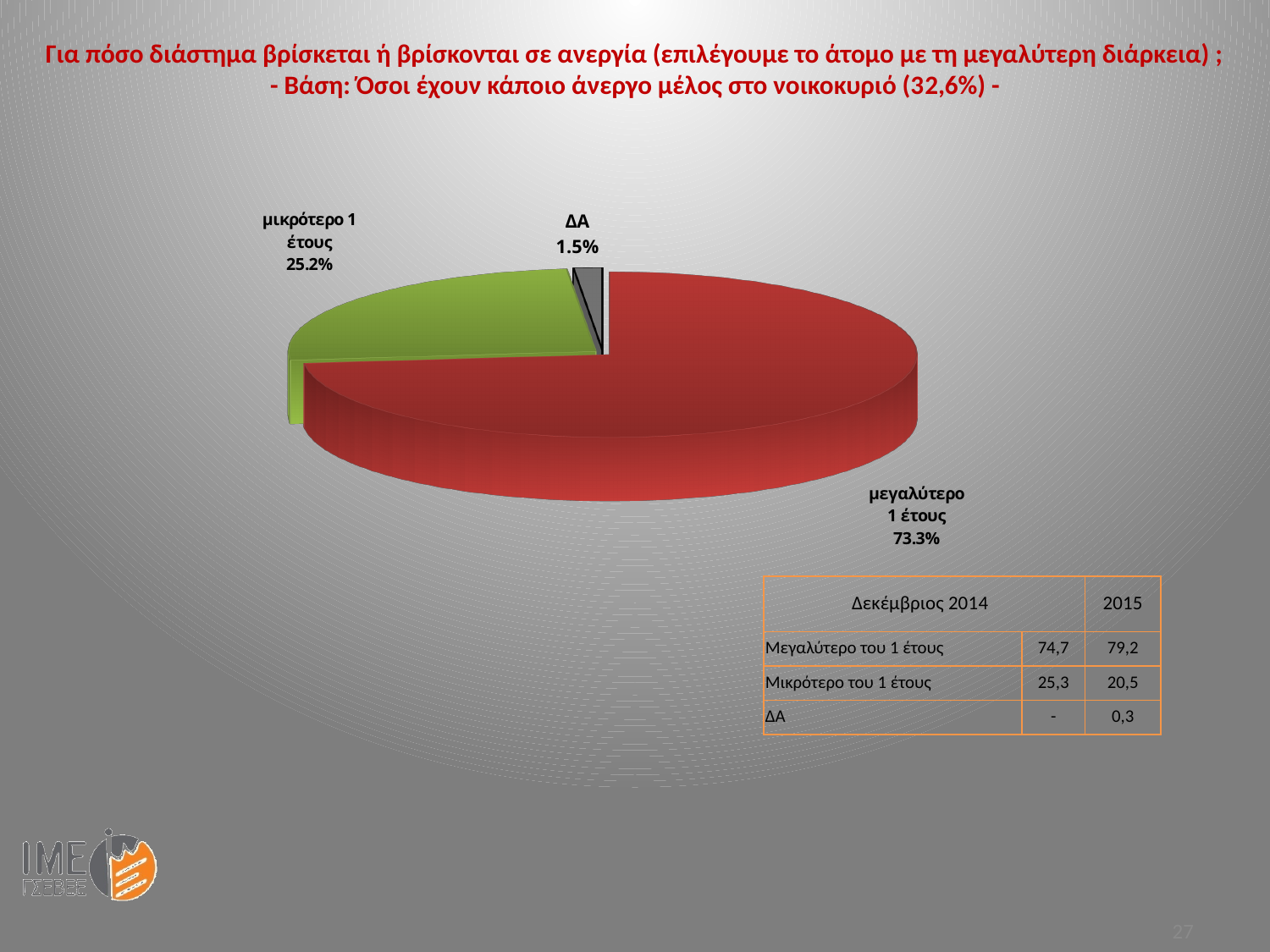
Which slice of the pie chart is the smallest? ΔΑ Which slice of the pie chart is the largest? μεγαλύτερο 1 έτους What is the difference in percentage points between the 'μικρότερο 1 έτους' and 'ΔΑ' slices? 23.7 What share of the pie does the slice 'μεγαλύτερο 1 έτους' represent? 73.3% Which is larger, the 'μικρότερο 1 έτους' slice or the 'ΔΑ' slice? μικρότερο 1 έτους What kind of chart is shown on the slide? pie chart What colour is the 'μεγαλύτερο 1 έτους' slice of the pie chart? red What colour is the 'μικρότερο 1 έτους' slice of the pie chart? green How many slices does the pie chart have? 3 What share of the pie does the slice 'μικρότερο 1 έτους' represent? 25.2% What is the difference in percentage points between the 'μεγαλύτερο 1 έτους' and 'μικρότερο 1 έτους' slices? 48.1 What is the value shown for the 'ΔΑ' slice? 1.5%